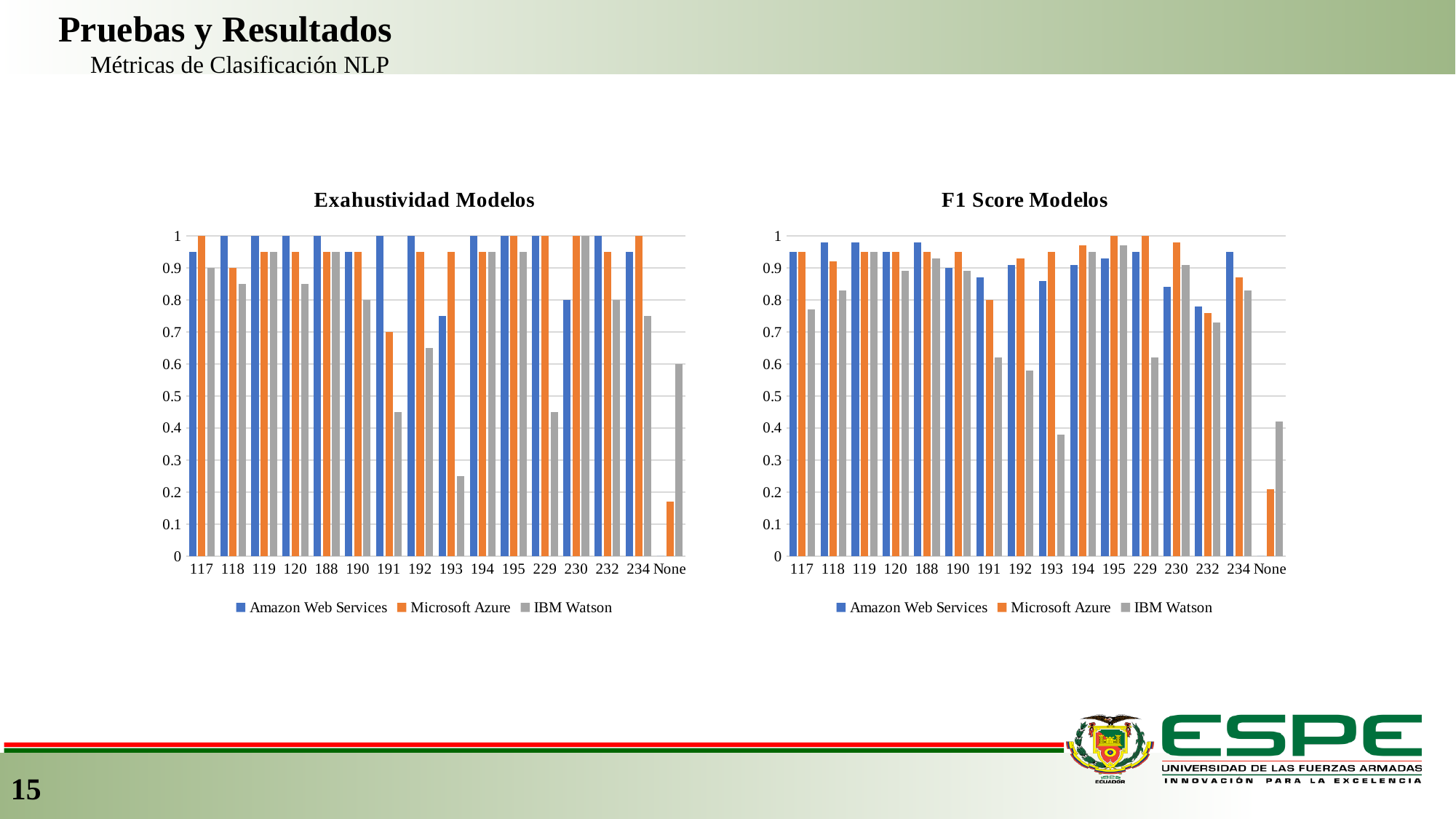
In the "Exahustividad Modelos" chart, at category 191, which is larger: Amazon Web Services or IBM Watson? Amazon Web Services In the "Exahustividad Modelos" chart, is the value for Microsoft Azure at category None greater or less than 0.2? less In the "F1 Score Modelos" chart, at category 117, which is larger: Amazon Web Services or IBM Watson? Amazon Web Services In the "F1 Score Modelos" chart, is the value for IBM Watson at category None greater or less than 0.5? less In the "Exahustividad Modelos" chart, what is the value for Amazon Web Services at category 118? 1 How many categories are shown on the x axis of the "Exahustividad Modelos" chart? 16 In the "Exahustividad Modelos" chart, which category has the lowest value for IBM Watson? 193 What are the three series listed in the legend of the "Exahustividad Modelos" chart? Amazon Web Services, Microsoft Azure, IBM Watson What kind of chart is the "Exahustividad Modelos" chart? bar chart How many series does the legend of the "F1 Score Modelos" chart list? 3 In the "Exahustividad Modelos" chart, is the value for IBM Watson at category 191 greater or less than 0.5? less In the "F1 Score Modelos" chart, which category has the lowest value for Microsoft Azure? None